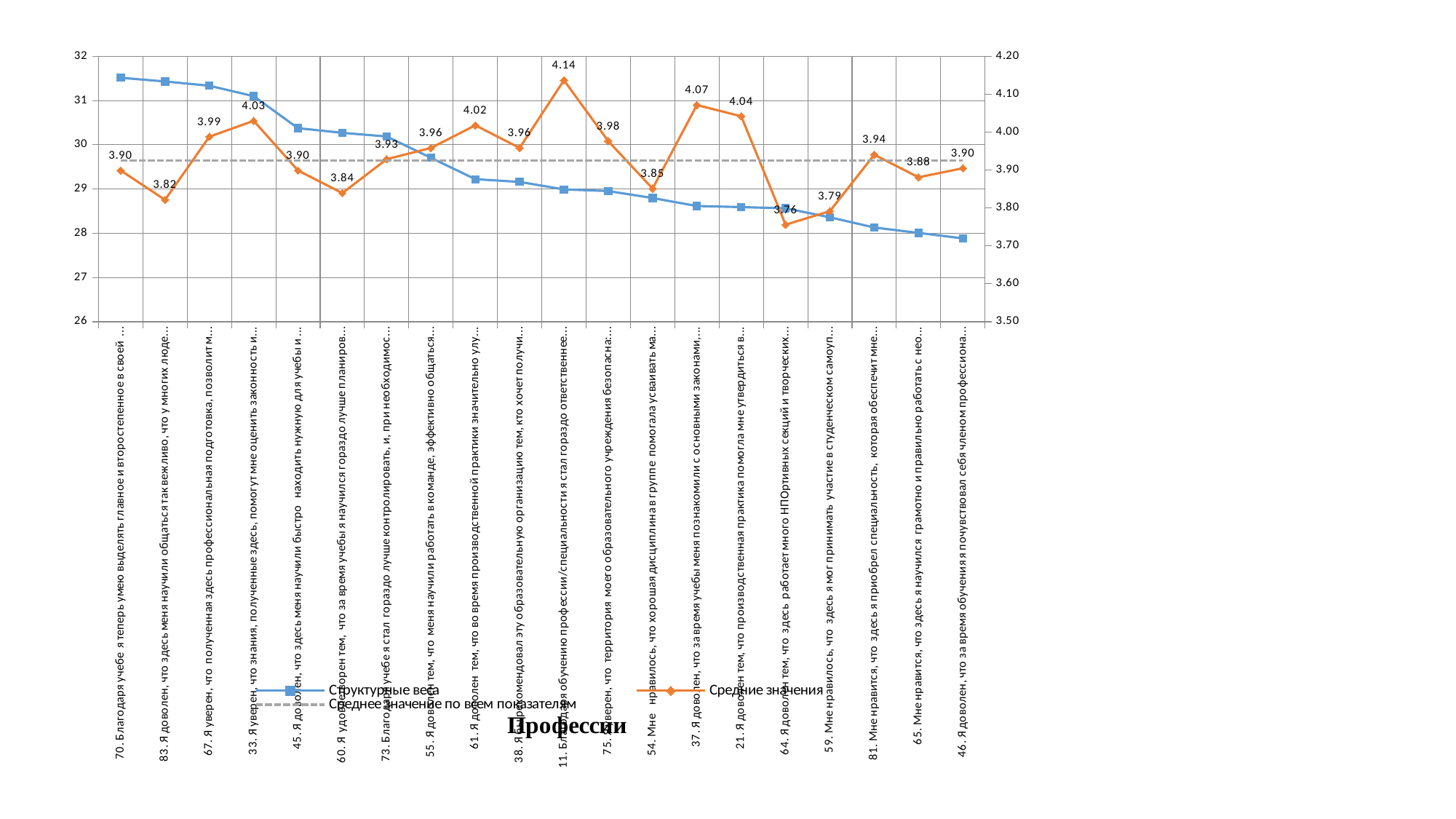
How many categories (statements) are plotted along the x axis? 20 Does the 'Структурные веса' series rise or fall along the x axis? falls Is the 'Структурные веса' value for statement 70 greater or less than 31? greater In the 'Средние значения' series, which is larger: statement 37 or statement 21? 37 Which statement has the lowest value in the 'Средние значения' series? 64 What is the difference between the highest (statement 11) and lowest (statement 64) values of the 'Средние значения' series? 0.38 How many series does the legend list? 3 What is the value of the 'Средние значения' series for statement 11? 4.14 What kind of chart is shown on the slide? line chart Which statement has the highest value in the 'Средние значения' series? 11 Is the 'Структурные веса' value for statement 46 greater or less than 29? less What is the value of the 'Средние значения' series for statement 83? 3.82